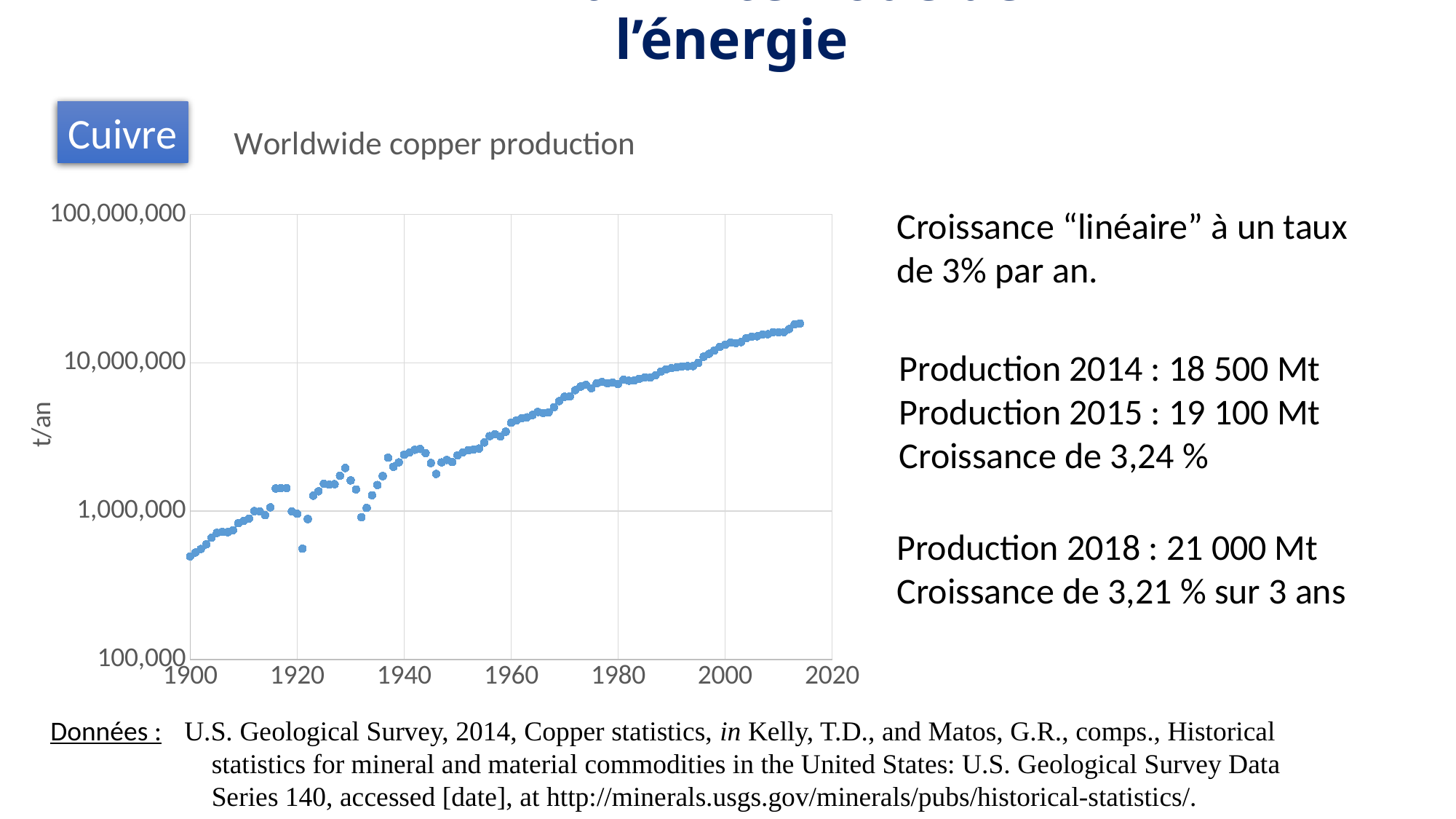
Is the value for 1960 greater or less than 10,000,000? less Which year has the larger value, 1940 or 1980? 1980 Is the value for 1960 greater or less than 1,000,000? greater Which year has the larger value, 1900 or 2000? 2000 Is the value for 1900 greater or less than 1,000,000? less What kind of chart is shown on the slide? scatter chart Do the plotted values generally rise or fall from 1900 to 2020? rise What is the title of the chart? Worldwide copper production What is the label on the y axis of the chart? t/an